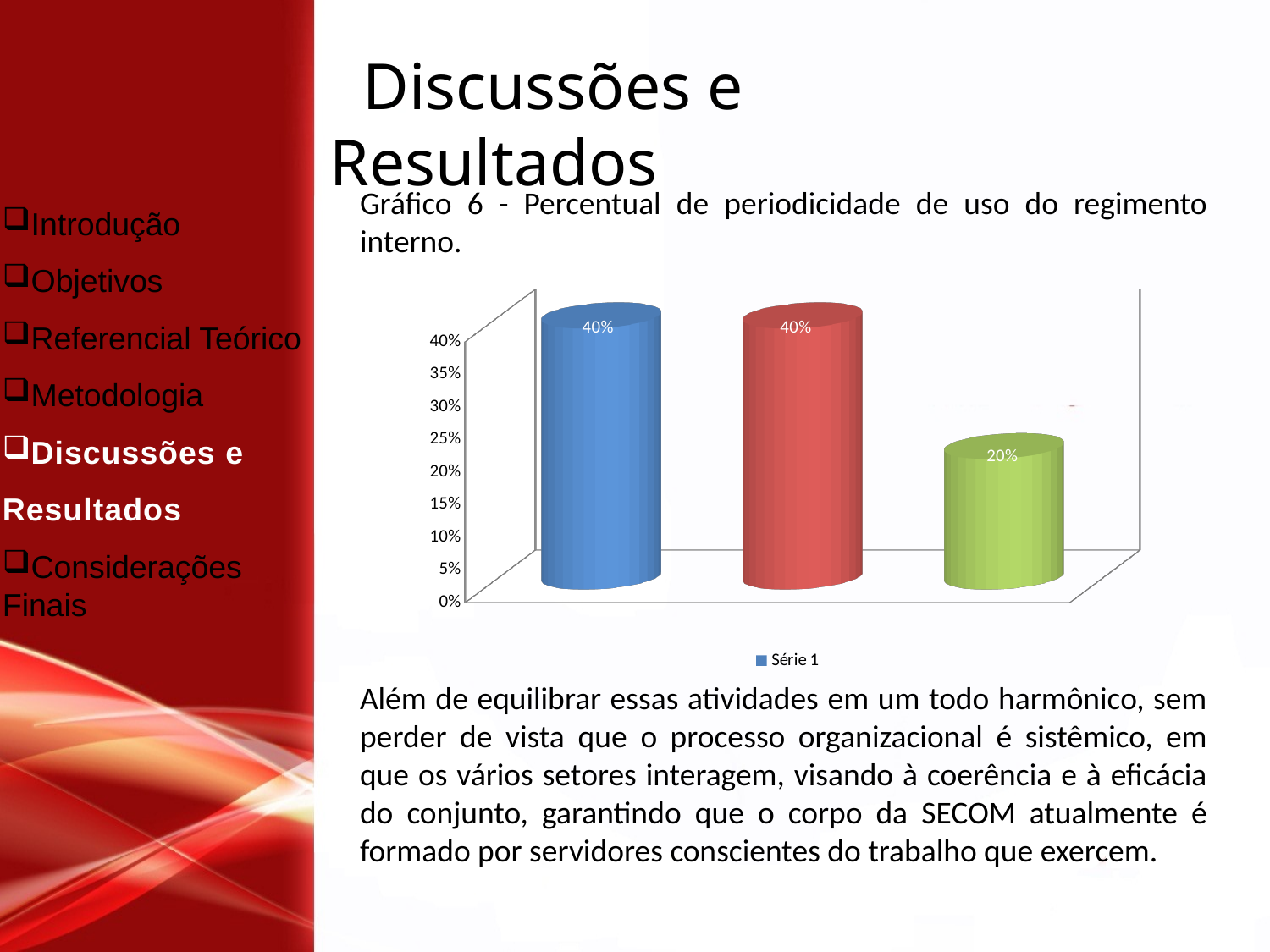
What is the value shown on the red (second) bar? 40% What is the value shown on the blue (first) bar? 40% What kind of chart is shown on the slide? bar chart Which is larger, the value of the red bar or the value of the green bar? the red bar Which bar has the lowest value? the green (third) bar What is the name of the series shown in the legend? Série 1 What is the difference between the value of the blue bar and the value of the green bar? 20% How many series does the legend list? 1 What is the value shown on the green (third) bar? 20% How many bars are plotted in the chart? 3 Is the value of the green bar greater or less than 30%? less What is the title of the chart as given on the slide? Gráfico 6 - Percentual de periodicidade de uso do regimento interno.